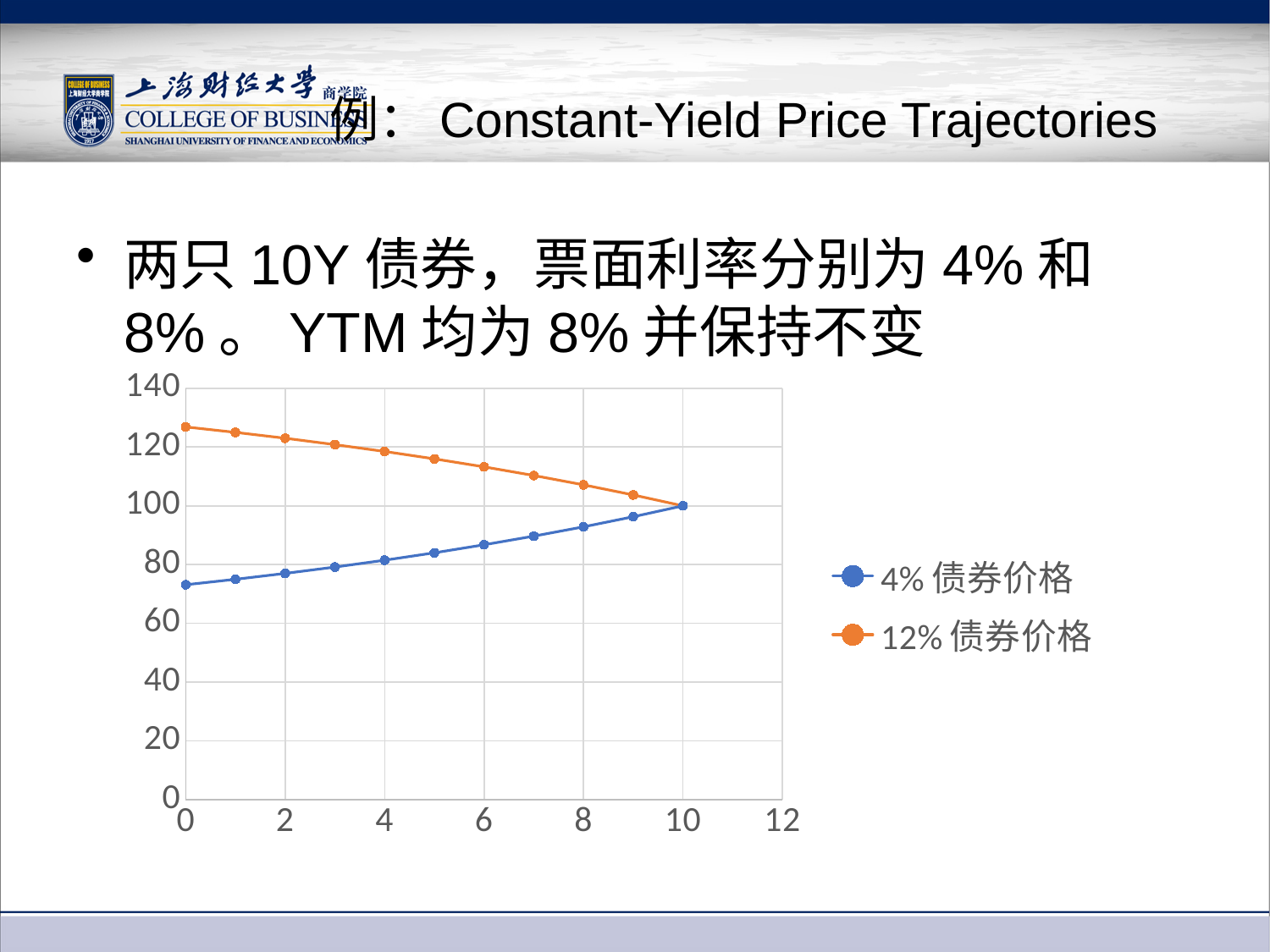
At which x value does the 12% 债券价格 series reach its highest point? 0 Is the value of the 4% 债券价格 series at x = 0 greater or less than 80? less Which colour is used for the 12% 债券价格 series? orange What value do both series reach at x = 10? 100 How many data points are plotted for each series? 11 What kind of chart is shown on the slide? line chart Is the value of the 12% 债券价格 series at x = 0 greater or less than 120? greater Does the 4% 债券价格 series rise or fall as the x axis goes from 0 to 10? rise What are the two series named in the chart legend? 4% 债券价格 and 12% 债券价格 How many series does the chart legend list? 2 At x = 4, which series has the higher value, 4% 债券价格 or 12% 债券价格? 12% 债券价格 Does the 12% 债券价格 series rise or fall as the x axis goes from 0 to 10? fall